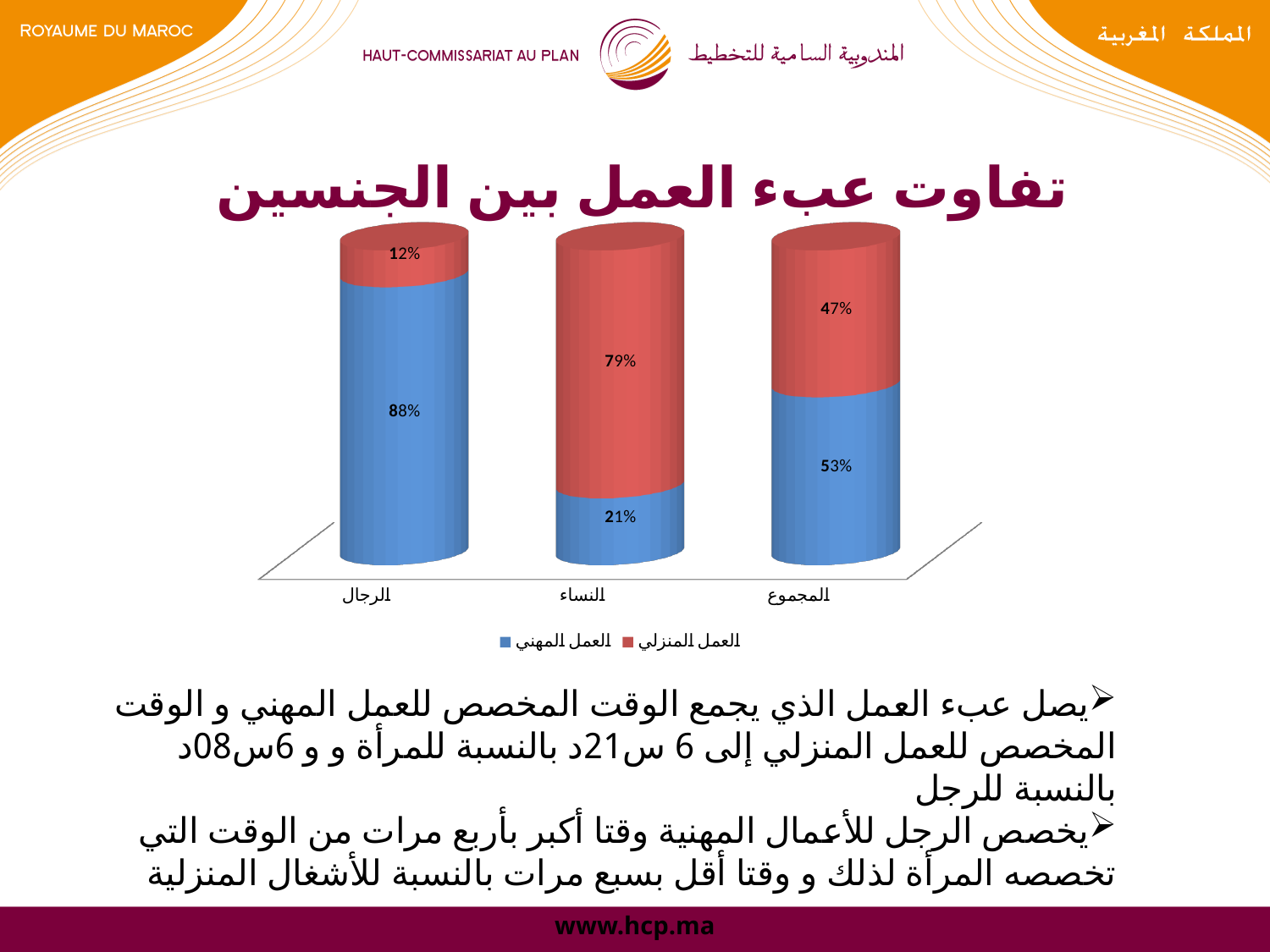
What is the value of the red segment for الرجال? 12% How many categories are shown on the x axis of the chart? 3 How many series does the chart legend list? 2 Which category has the larger blue segment, الرجال or النساء? الرجال What is the title of the chart? تفاوت عبء العمل بين الجنسين What is the value of the red segment for النساء? 79% What is the value of the blue segment for المجموع? 53% Which category has the largest red segment? النساء What is the total of the two segments in the bar for النساء? 100% What kind of chart is shown on the slide? Stacked bar chart What is the value of the blue segment for الرجال? 88% What is the difference between the blue segment for الرجال and the blue segment for النساء? 67 percentage points